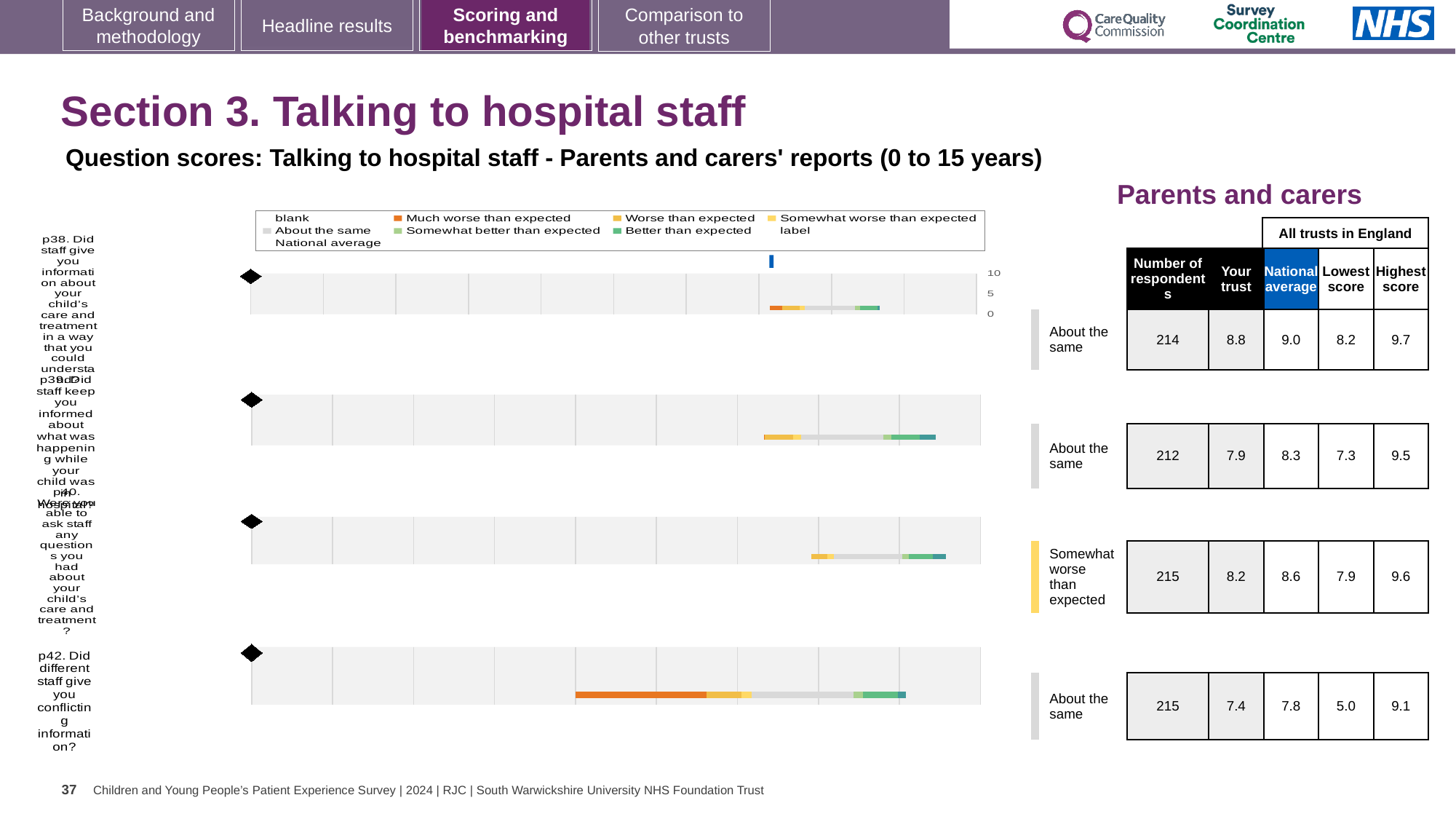
Which question has the highest 'Your trust' score in the Parents and carers table? p38 Which has the higher 'Your trust' score: p40 or p39? p40 In the Parents and carers table, what is the Lowest score for p42 (Did different staff give you conflicting information)? 5.0 What kind of chart is used to show the benchmarking results for each question on this slide? bar chart For p38, how much higher is the National average than the 'Your trust' score? 0.2 In the Parents and carers table, how many respondents are listed for p40 (Were you able to ask staff any questions you had about your child's care and treatment)? 215 In the Parents and carers table, what is the Highest score for p42 (Did different staff give you conflicting information)? 9.1 In the Parents and carers table, what is the 'Your trust' score for p38 (Did staff give you information about your child's care and treatment in a way that you could understand)? 8.8 In the Parents and carers table, what is the National average for p39 (Did staff keep you informed about what was happening while your child was in hospital)? 8.3 Which question has the lowest 'Your trust' score in the Parents and carers table? p42 What benchmarking category is shown next to the chart for p40 (Were you able to ask staff any questions you had about your child's care and treatment)? Somewhat worse than expected How many question charts (p38, p39, p40, p42) are shown on the slide? 4